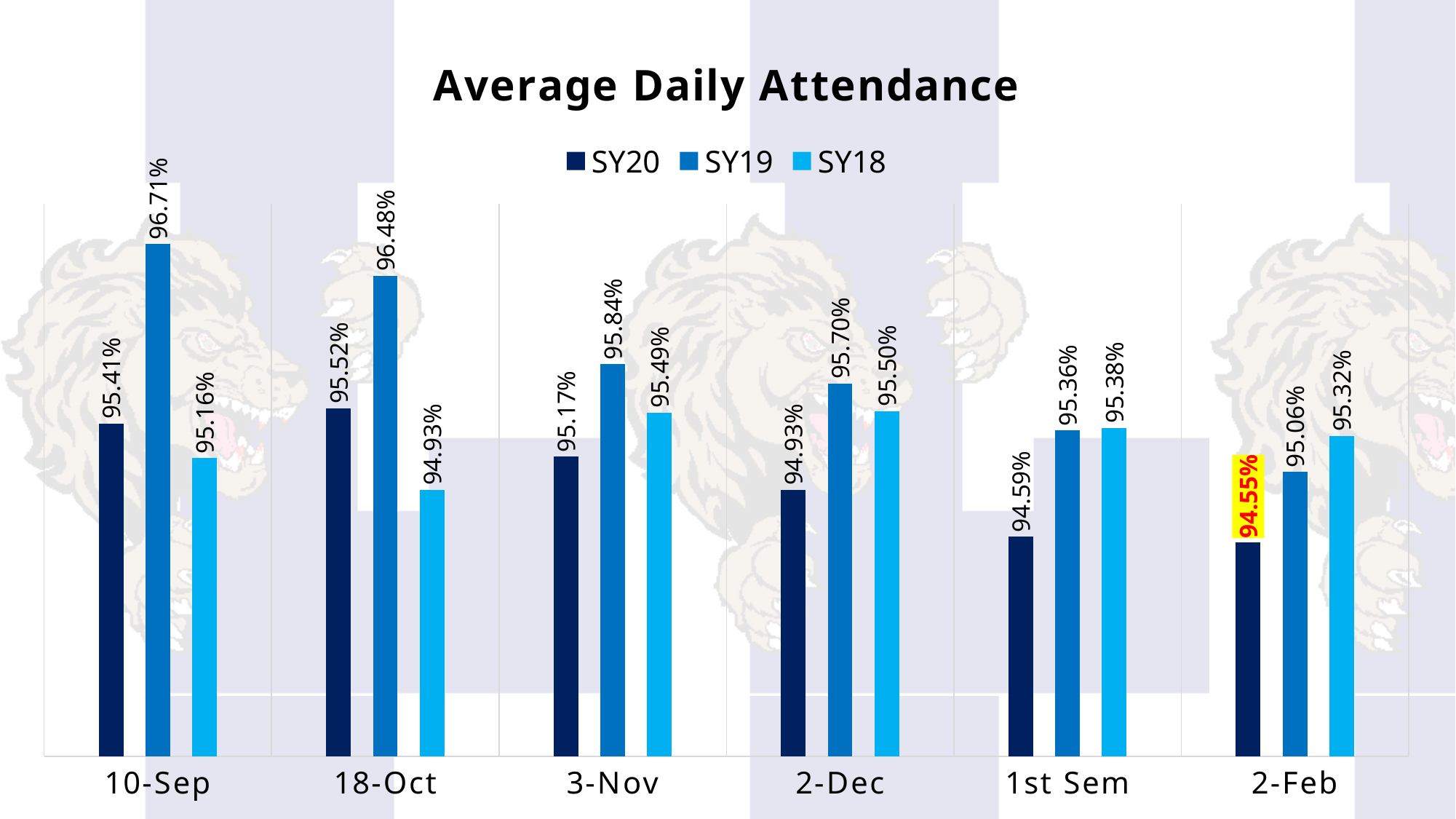
What is the SY20 value for 2-Feb? 94.55% What is the title of the chart? Average Daily Attendance Which category has the highest SY19 value? 10-Sep What is the difference between the SY19 and SY20 values for 10-Sep? 1.30% How many categories are shown on the x axis? 6 What kind of chart is shown? bar chart How many series does the legend list? 3 What is the SY19 value for 18-Oct? 96.48% For 18-Oct, which is larger: the SY20 value or the SY18 value? SY20 Which category has the lowest SY20 value? 2-Feb What is the SY18 value for 3-Nov? 95.49% What is the SY20 value for 10-Sep? 95.41%